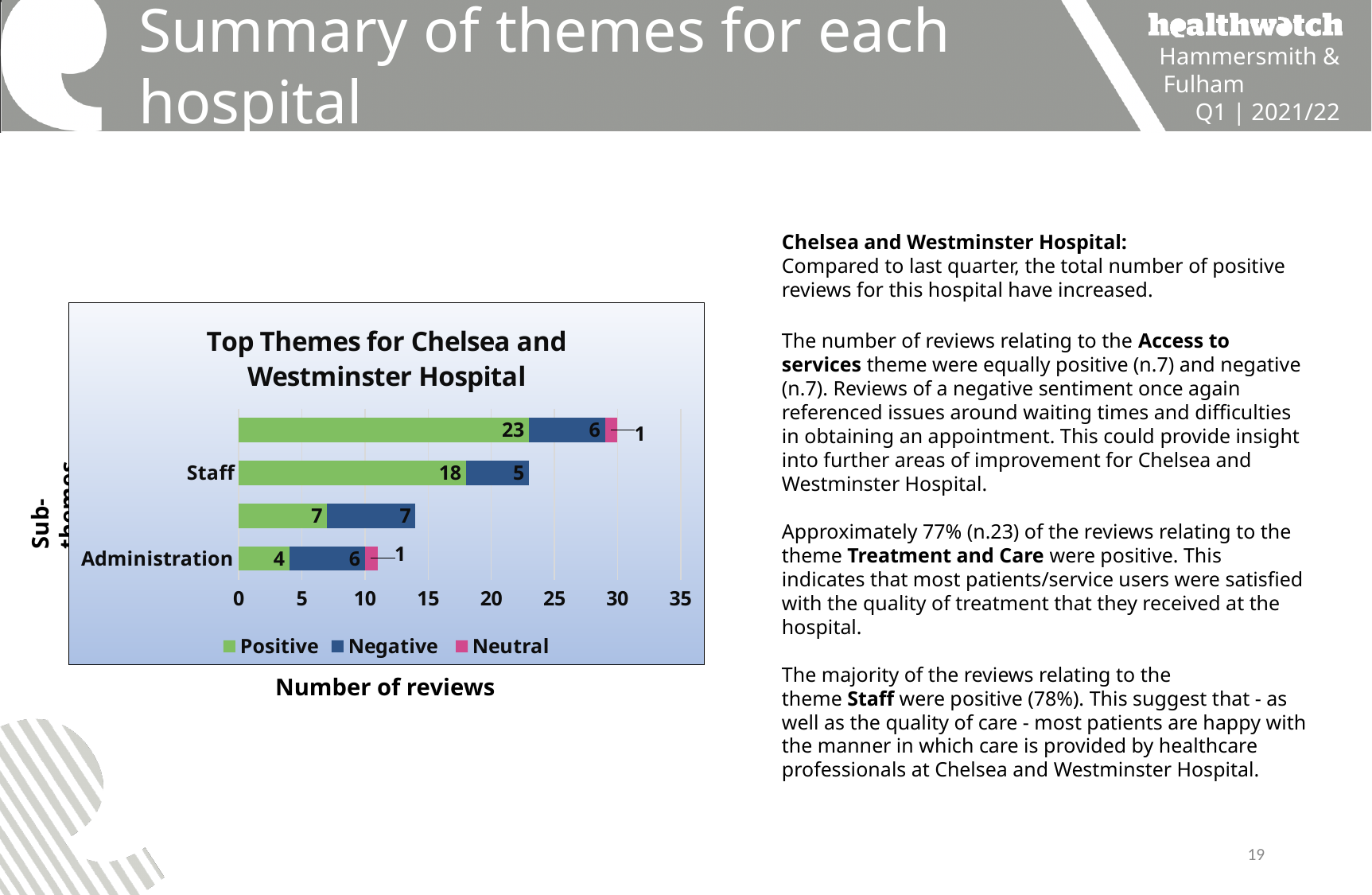
What is the title of the chart? Top Themes for Chelsea and Westminster Hospital For Administration, which is larger: the Positive value or the Negative value? Negative What kind of chart is shown on the slide? Stacked bar chart What is the Negative value for Staff? 5 What is the Positive value for Staff? 18 What is the difference between the Positive and Negative values for Staff? 13 What is the Neutral value for Administration? 1 What is the total number of reviews in the Administration bar? 11 What is the Negative value for Administration? 6 How many series does the legend list? 3 What is the total number of reviews in the Staff bar? 23 What is the Positive value for Administration? 4